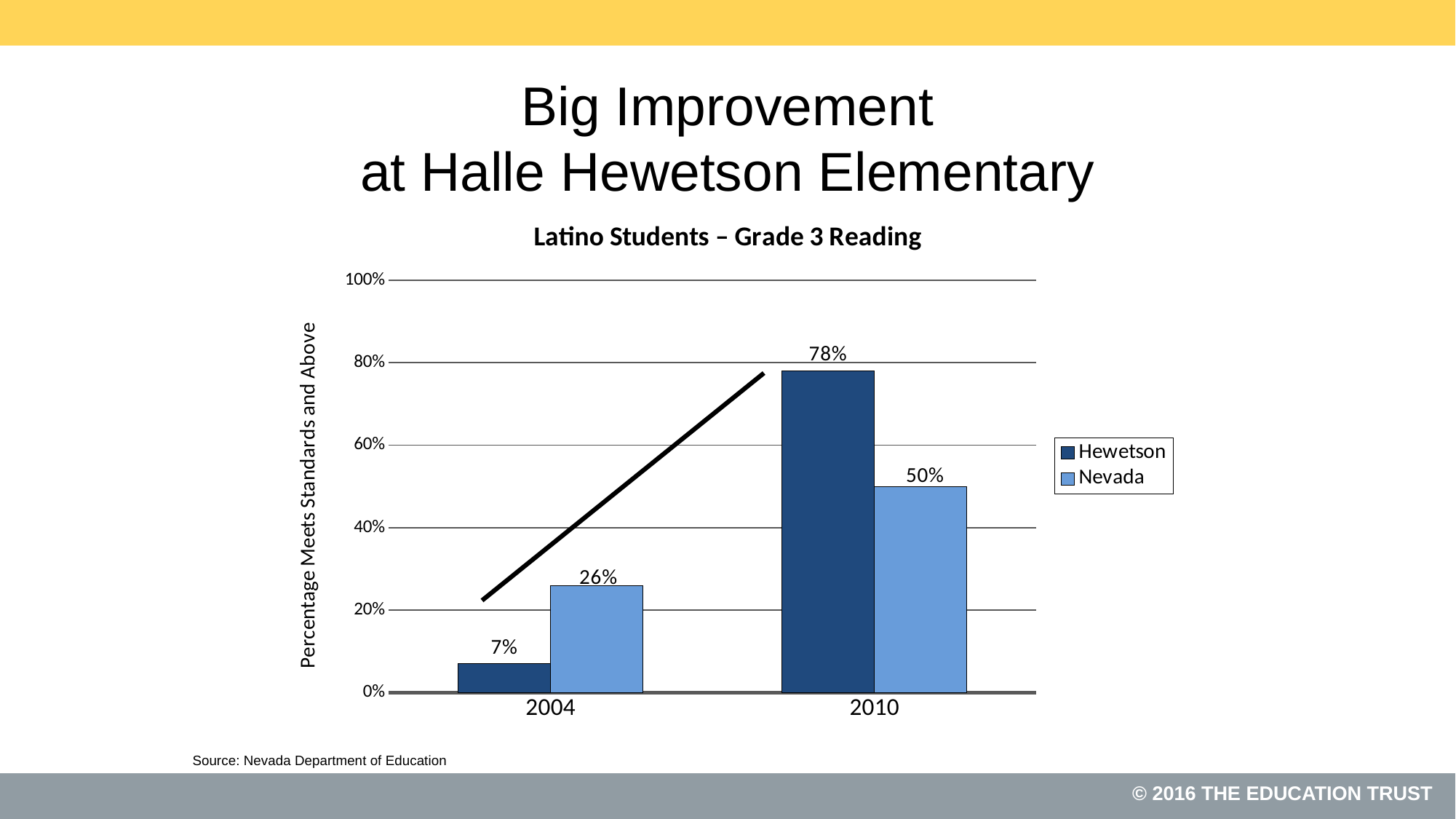
Which series has the highest value shown on the chart? Hewetson What was the Hewetson value for 2010? 78% What percentage of Latino students at Hewetson met standards and above in Grade 3 Reading in 2004? 7% What was the Nevada value for 2004? 26% By how many percentage points did the Hewetson value increase from 2004 to 2010? 71 What was the Nevada value for 2010? 50% How many series does the legend list? 2 Which bar has the lowest value on the chart? Hewetson in 2004 What is the title of the chart? Latino Students – Grade 3 Reading What kind of chart is shown on the slide? Bar chart What is the difference between the Hewetson and Nevada values in 2010? 28% In 2004, which was larger, the Hewetson value or the Nevada value? Nevada